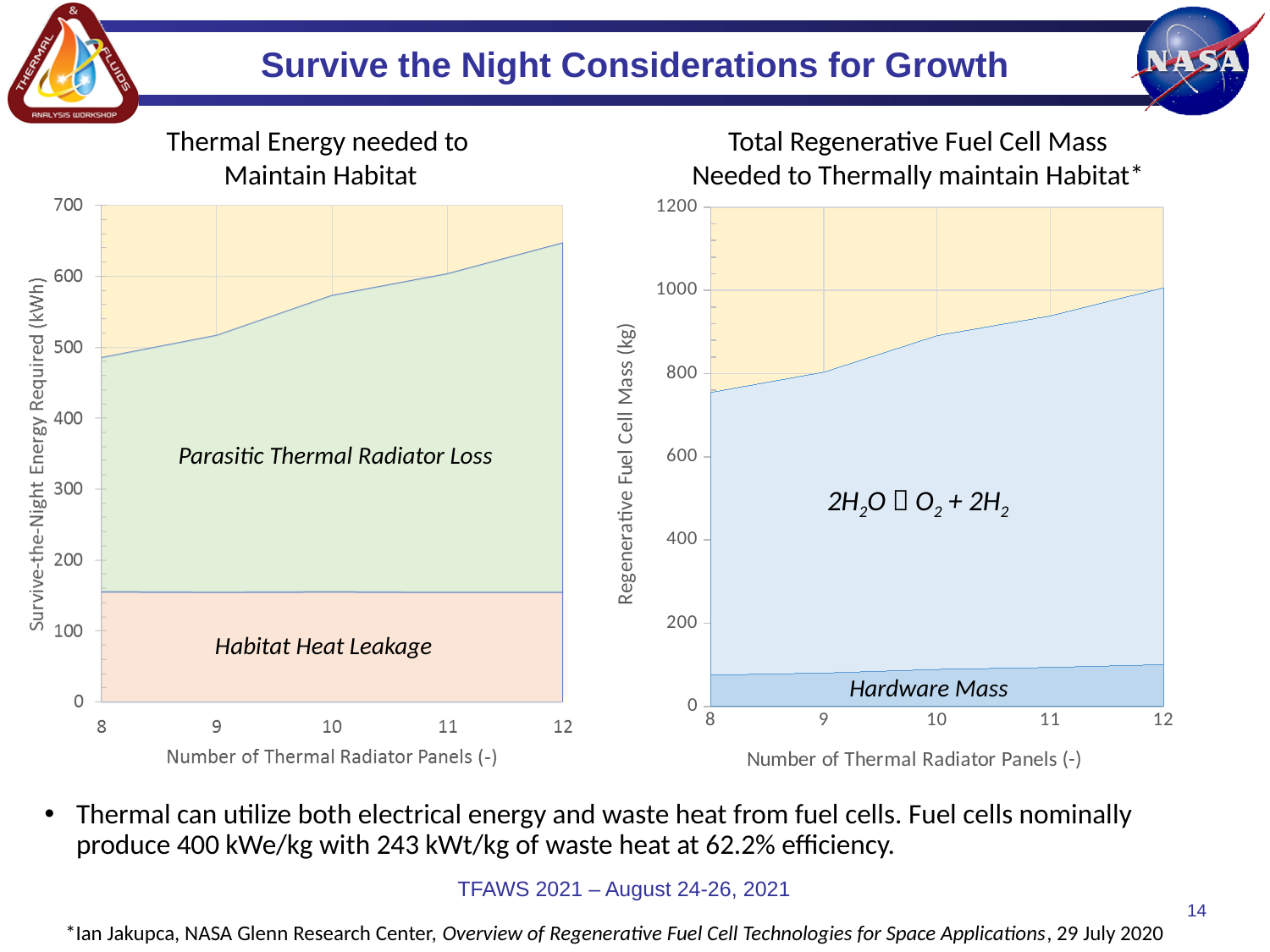
What type of chart is the left chart, 'Thermal Energy needed to Maintain Habitat'? Area chart In the left chart, 'Thermal Energy needed to Maintain Habitat', does the total energy required rise or fall as the number of thermal radiator panels increases from 8 to 12? Rise In the left chart, 'Thermal Energy needed to Maintain Habitat', is the total energy required at 12 panels greater or less than 600 kWh? greater In the left chart, 'Thermal Energy needed to Maintain Habitat', what are the two labelled regions of the area chart? Parasitic Thermal Radiator Loss and Habitat Heat Leakage In the left chart, 'Thermal Energy needed to Maintain Habitat', is the Habitat Heat Leakage value greater or less than 200 kWh? less How many values of Number of Thermal Radiator Panels are shown on the x axis of the right chart, 'Total Regenerative Fuel Cell Mass Needed to Thermally maintain Habitat'? 5 In the right chart, 'Total Regenerative Fuel Cell Mass Needed to Thermally maintain Habitat', is the Hardware Mass greater or less than 200 kg? less In the left chart, 'Thermal Energy needed to Maintain Habitat', at which number of radiator panels is the total energy required highest? 12 In the right chart, 'Total Regenerative Fuel Cell Mass Needed to Thermally maintain Habitat', which is larger: the total fuel cell mass at 8 panels or at 12 panels? 12 panels